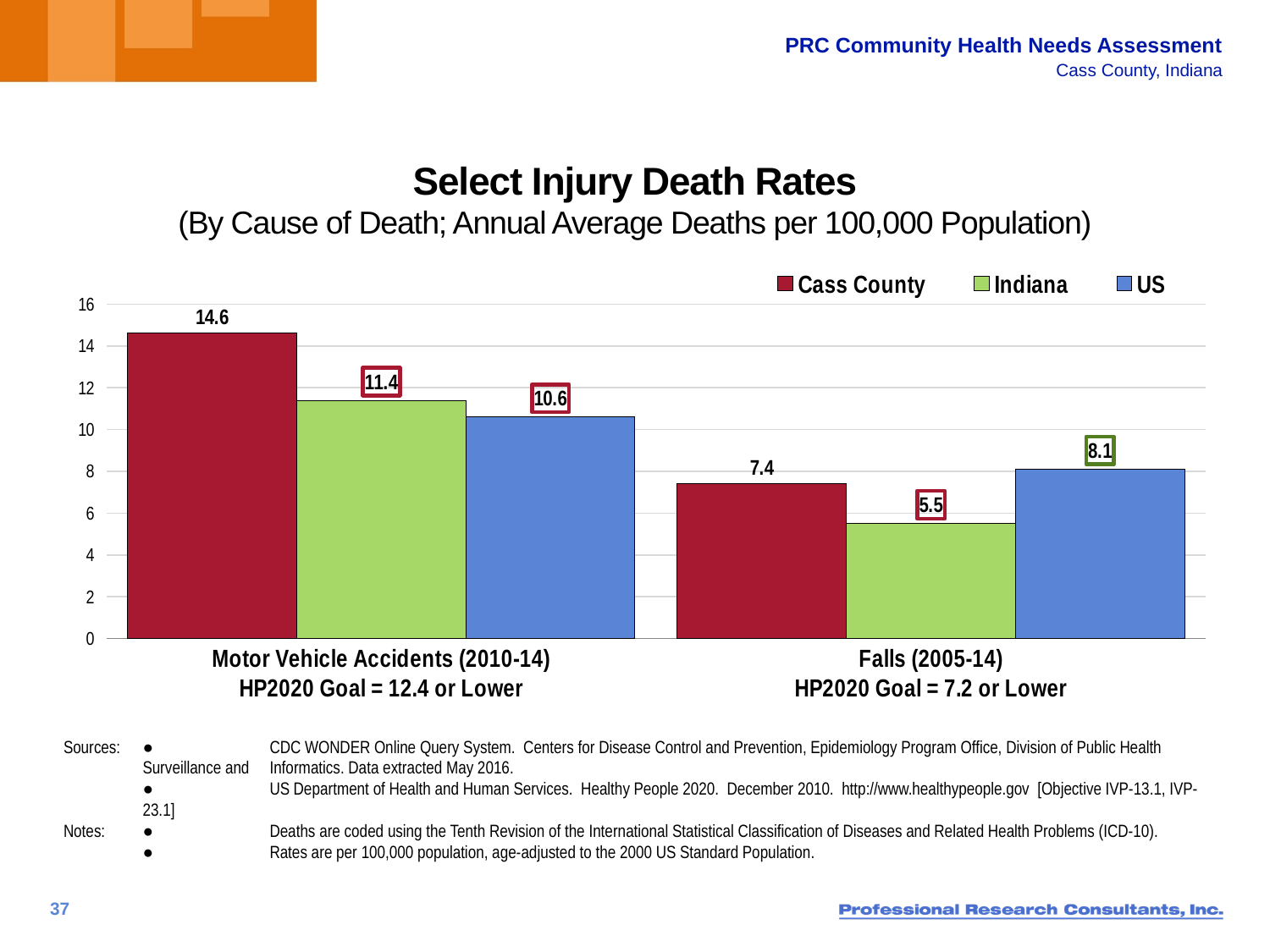
What is the HP2020 Goal shown for Motor Vehicle Accidents (2010-14)? 12.4 or Lower Which is larger for Falls (2005-14): the Cass County value or the US value? US What is the US value for Falls (2005-14)? 8.1 Which series has the lowest value for Falls (2005-14)? Indiana Which series has the highest value for Motor Vehicle Accidents (2010-14)? Cass County Is the Cass County value for Falls (2005-14) greater or less than 8? less What is the Indiana value for Falls (2005-14)? 5.5 What kind of chart is shown on the slide? Bar chart What is the difference between the Cass County and Indiana values for Motor Vehicle Accidents (2010-14)? 3.2 What is the Cass County value for Motor Vehicle Accidents (2010-14)? 14.6 How many series does the legend list? 3 What is the US value for Motor Vehicle Accidents (2010-14)? 10.6